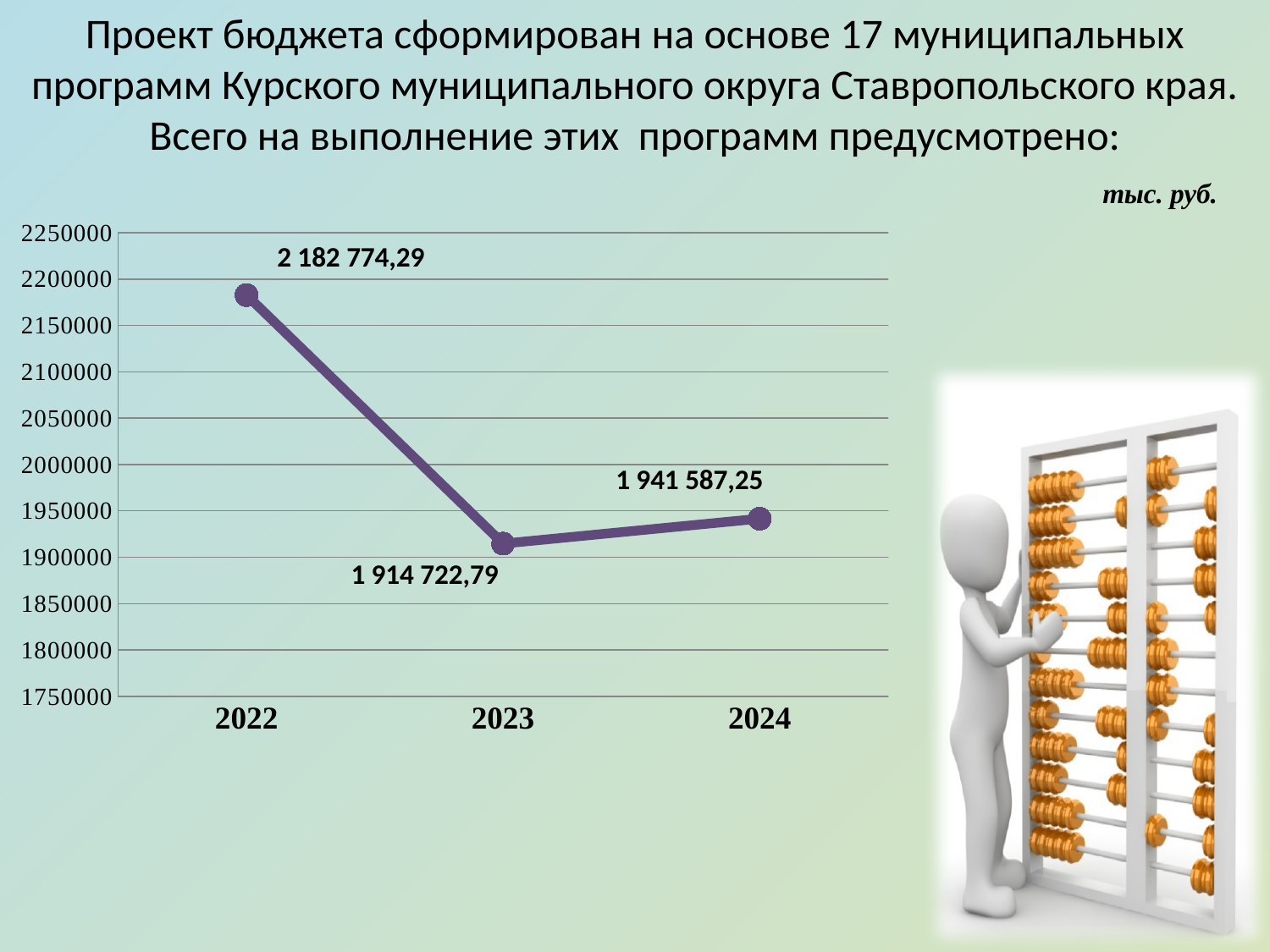
Is the value for 2022 greater or less than 2150000? greater What is the difference between the values for 2022 and 2023? 268 051,50 Which is larger, the value for 2023 or the value for 2024? 2024 What is the difference between the values for 2024 and 2023? 26 864,46 How many data points are plotted on the chart? 3 What is the value for 2022? 2 182 774,29 What is the value for 2024? 1 941 587,25 Which year has the highest value? 2022 What is the value for 2023? 1 914 722,79 Which year has the lowest value? 2023 What kind of chart is shown on the slide? line chart What unit is indicated for the values on the chart? тыс. руб.